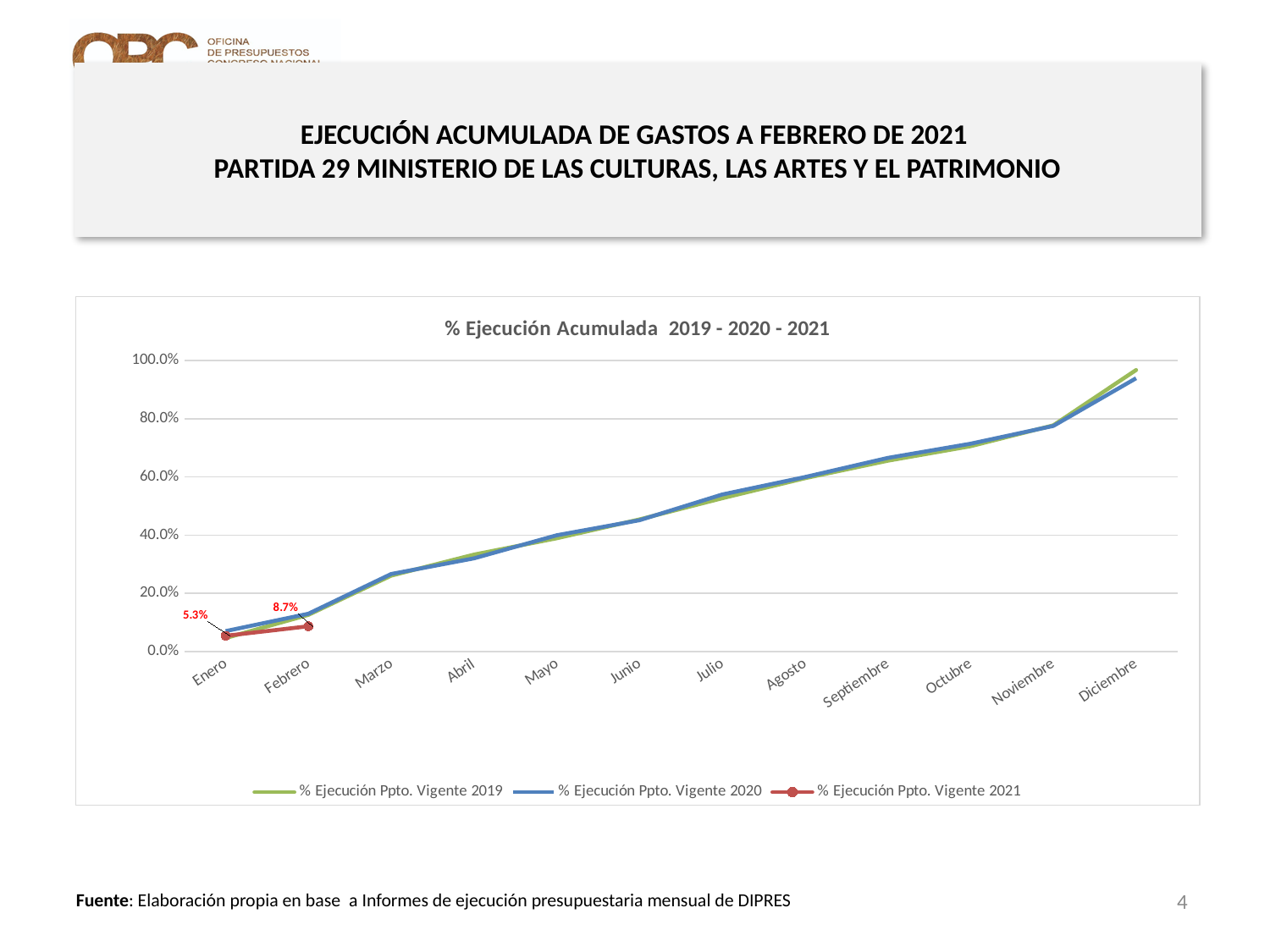
How many series does the legend list? 3 What is the value of % Ejecución Ppto. Vigente 2021 for Enero? 5.3% What kind of chart is shown on the slide? Line chart How many months are shown along the x axis? 12 Is the value for % Ejecución Ppto. Vigente 2020 in Noviembre greater or less than 80.0%? less Is the value for % Ejecución Ppto. Vigente 2020 in Diciembre greater or less than 80.0%? greater What is the title of the chart? % Ejecución Acumulada 2019 - 2020 - 2021 By how many percentage points did % Ejecución Ppto. Vigente 2021 increase from Enero to Febrero? 3.4 Is the value for % Ejecución Ppto. Vigente 2019 in Marzo greater or less than 20.0%? greater What is the value of % Ejecución Ppto. Vigente 2021 for Febrero? 8.7% Do the 2019 and 2020 series rise or fall from Enero to Diciembre? Rise For the 2021 series, which month has the higher value, Enero or Febrero? Febrero